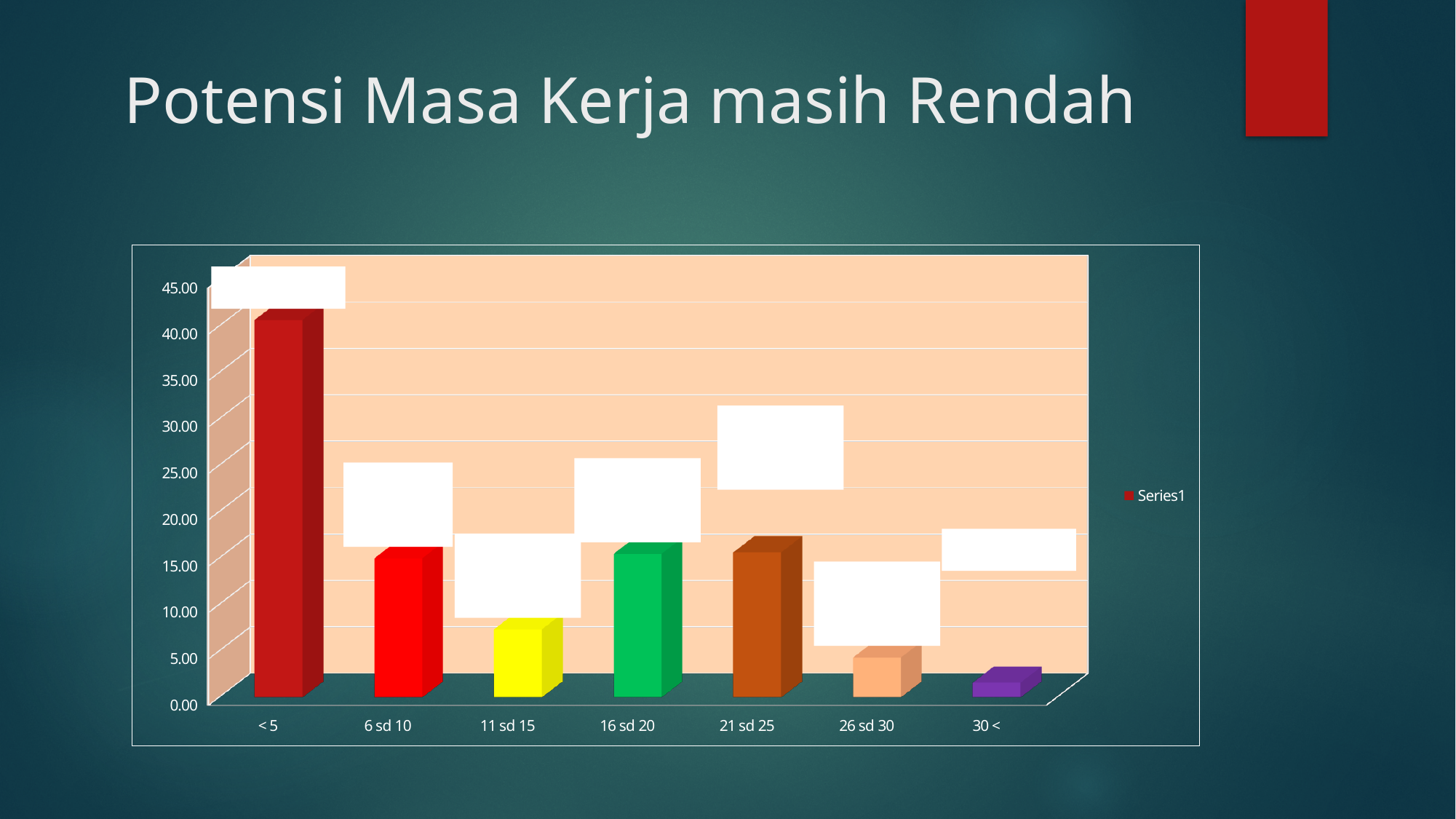
What is the name of the series shown in the chart legend? Series1 Is the value for 21 sd 25 greater or less than 10? greater How many series does the chart legend list? 1 Which is larger, the value for < 5 or the value for 6 sd 10? < 5 Which category has the highest bar in the chart? < 5 How many categories are shown on the x axis of the chart? 7 Is the value for < 5 greater or less than 35? greater Is the value for 11 sd 15 greater or less than 10? less Which category has the lowest bar in the chart? 30 < What kind of chart is shown on the slide? bar chart